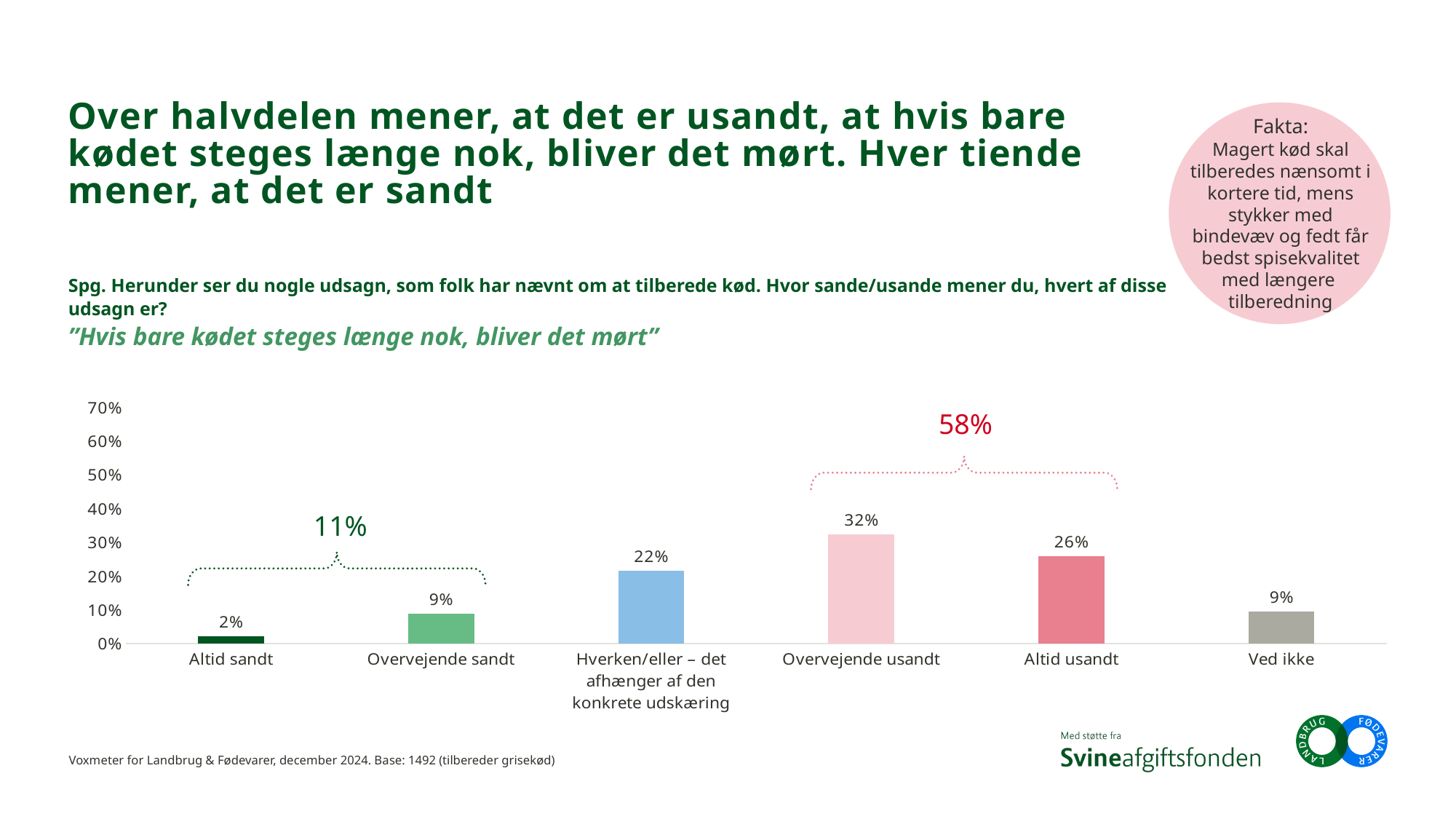
What is the value shown for "Overvejende usandt"? 32% What percentage of respondents answered "Altid sandt"? 2% What is the value shown for "Hverken/eller – det afhænger af den konkrete udskæring"? 22% Which category has the lowest value? Altid sandt What is the value shown for "Ved ikke"? 9% Which is larger, the value for "Altid usandt" or the value for "Hverken/eller – det afhænger af den konkrete udskæring"? Altid usandt What is the difference between the values for "Overvejende usandt" and "Altid usandt"? 6% What kind of chart is shown on the slide? Bar chart How many categories are shown on the x axis of the chart? 6 Which category has the highest value? Overvejende usandt What combined percentage is shown by the bracket above "Altid sandt" and "Overvejende sandt"? 11% What combined percentage is shown by the bracket above "Overvejende usandt" and "Altid usandt"? 58%